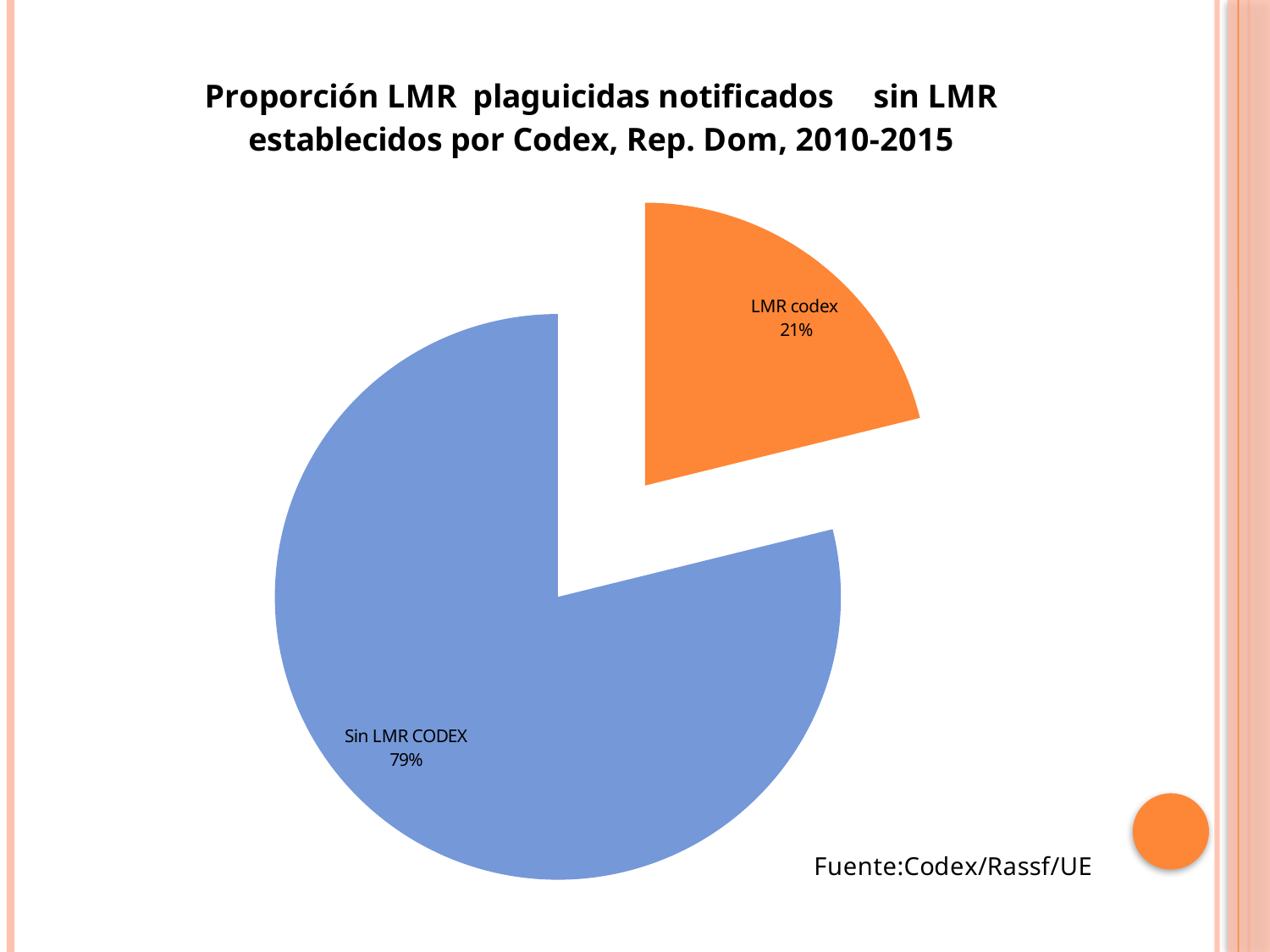
What kind of chart is shown on the slide? pie chart What is the difference in percentage points between the "Sin LMR CODEX" slice and the "LMR codex" slice? 58 Which is larger, the "LMR codex" slice or the "Sin LMR CODEX" slice? Sin LMR CODEX What is the total of the two slice percentages shown? 100% Which slice of the pie is the largest? Sin LMR CODEX How many slices does the pie chart have? 2 Which slice of the pie is the smallest? LMR codex What share of the pie does the "LMR codex" slice represent? 21% What share of the pie does the "Sin LMR CODEX" slice represent? 79% What colour is the "LMR codex" slice? orange What is the title of the chart? Proporción LMR plaguicidas notificados sin LMR establecidos por Codex, Rep. Dom, 2010-2015